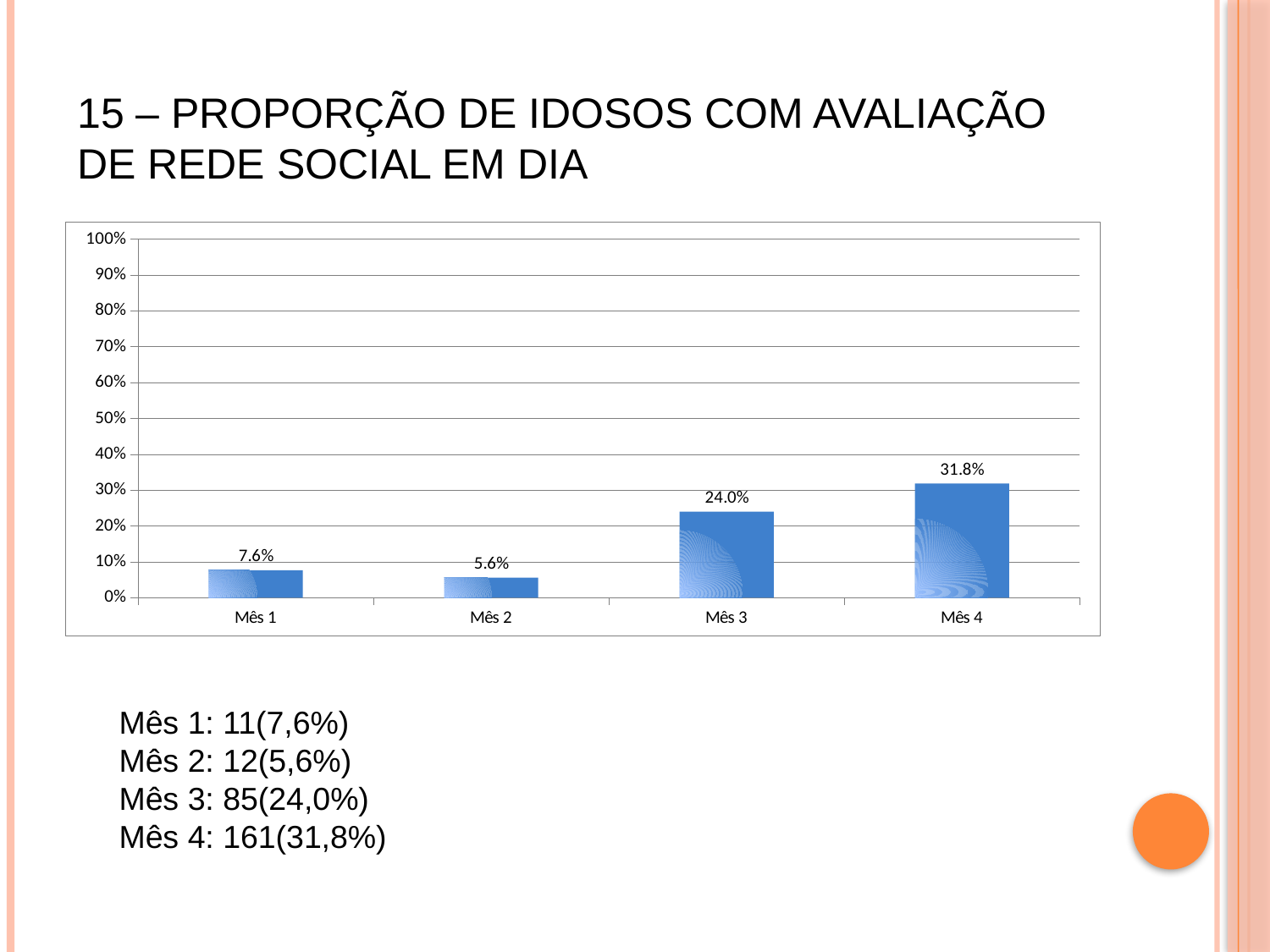
Is the value for Mês 4 greater or less than 40%? less What is the value for Mês 1? 7.6% What kind of chart is shown on the slide? bar chart What is the value for Mês 3? 24.0% How many months are shown on the x axis? 4 What is the difference between the values for Mês 1 and Mês 2? 2.0% Which month has the highest value? Mês 4 What is the value for Mês 2? 5.6% Which is larger, the value for Mês 3 or the value for Mês 1? Mês 3 What is the difference between the values for Mês 4 and Mês 3? 7.8% Which month has the lowest value? Mês 2 What is the value for Mês 4? 31.8%